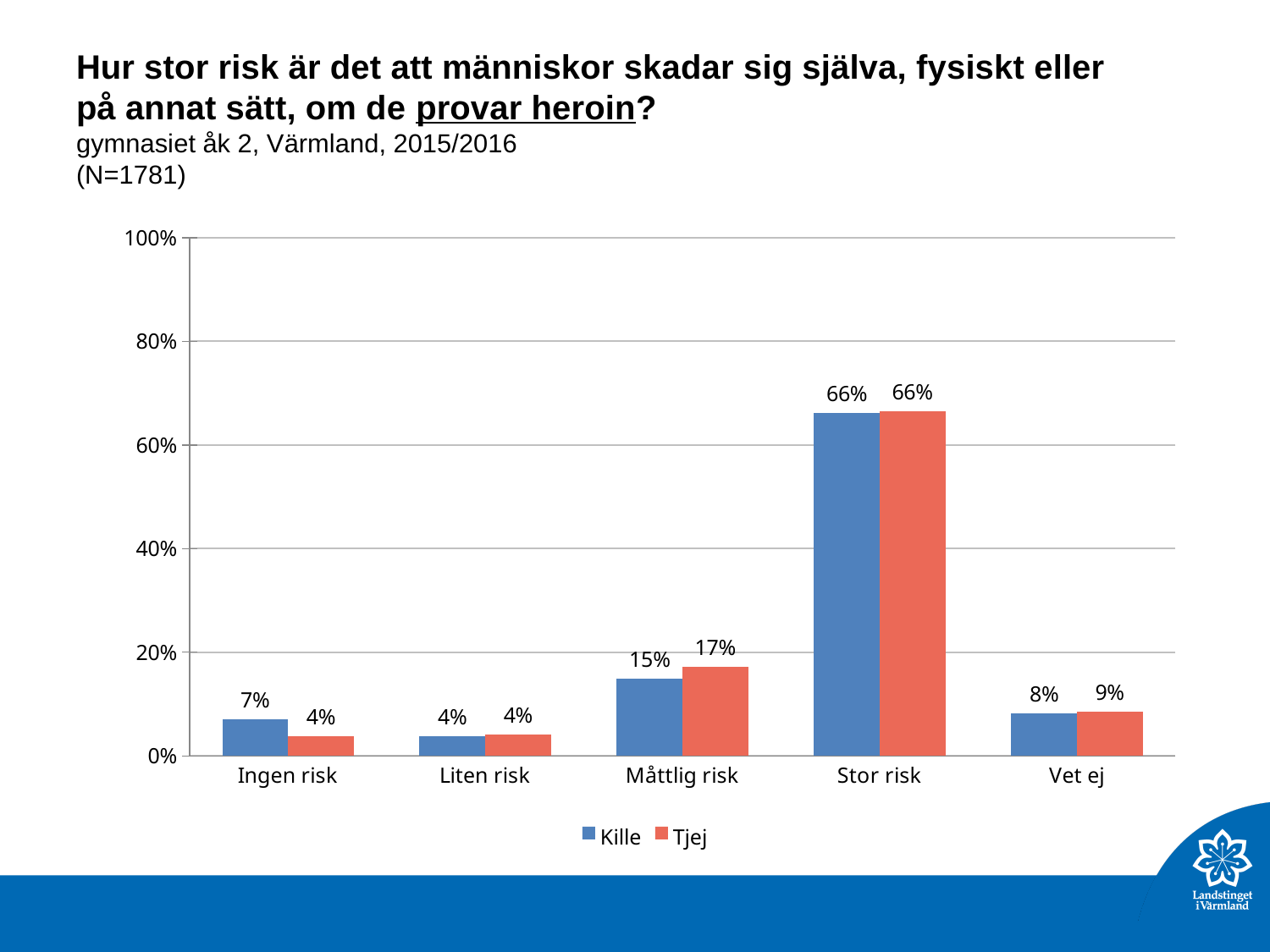
Which is larger in the Ingen risk category, the value for Kille or for Tjej? Kille How many series does the legend list? 2 What is the difference between the Tjej and Kille values in the Måttlig risk category? 2% Which category has the lowest value for Tjej? Ingen risk and Liten risk (both 4%) How many categories are shown on the x axis? 5 Which category has the highest value for Kille? Stor risk What kind of chart is shown on the slide? bar chart What are the two series named in the legend? Kille and Tjej What is the value for Tjej in the Vet ej category? 9% Is the value for Kille in the Stor risk category greater or less than 60%? greater What is the value for Kille in the Ingen risk category? 7% What is the value for Tjej in the Måttlig risk category? 17%